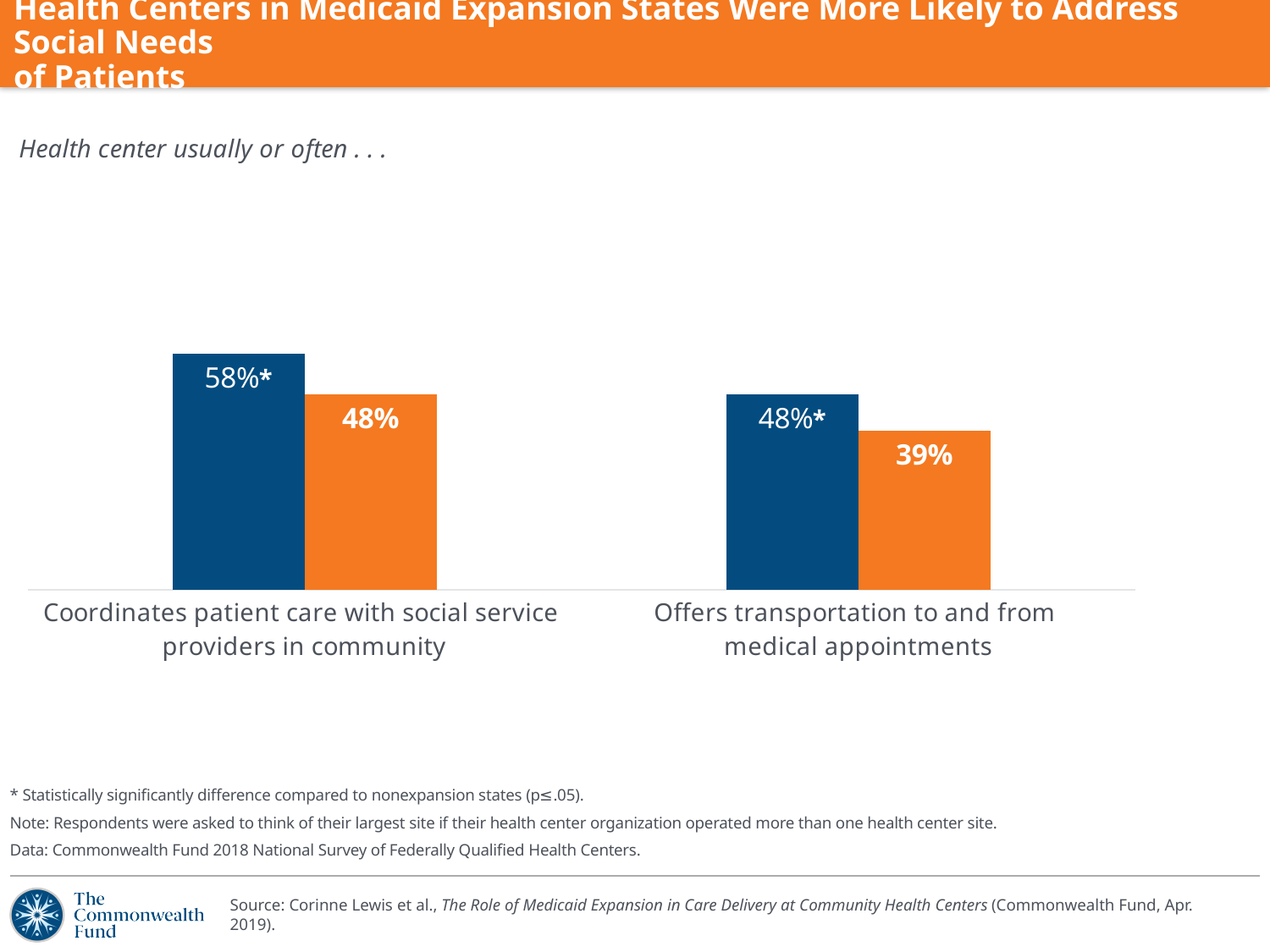
Which bar is the shortest in the chart? Orange bar for 'Offers transportation to and from medical appointments' (39%) What is the difference between the blue and orange bars for 'Offers transportation to and from medical appointments'? 9 percentage points What is the italic subtitle text shown above the chart? Health center usually or often . . . Which bar is the tallest in the chart? Blue bar for 'Coordinates patient care with social service providers in community' (58%) How many categories are shown on the x axis of the chart? 2 What is the value of the blue bar for 'Offers transportation to and from medical appointments'? 48% What is the value of the orange bar for 'Coordinates patient care with social service providers in community'? 48% What type of chart is shown on the slide? bar chart For 'Offers transportation to and from medical appointments', which bar is larger, the blue or the orange? blue What is the value of the blue bar for 'Coordinates patient care with social service providers in community'? 58% What is the value of the orange bar for 'Offers transportation to and from medical appointments'? 39% What is the difference between the blue and orange bars for 'Coordinates patient care with social service providers in community'? 10 percentage points